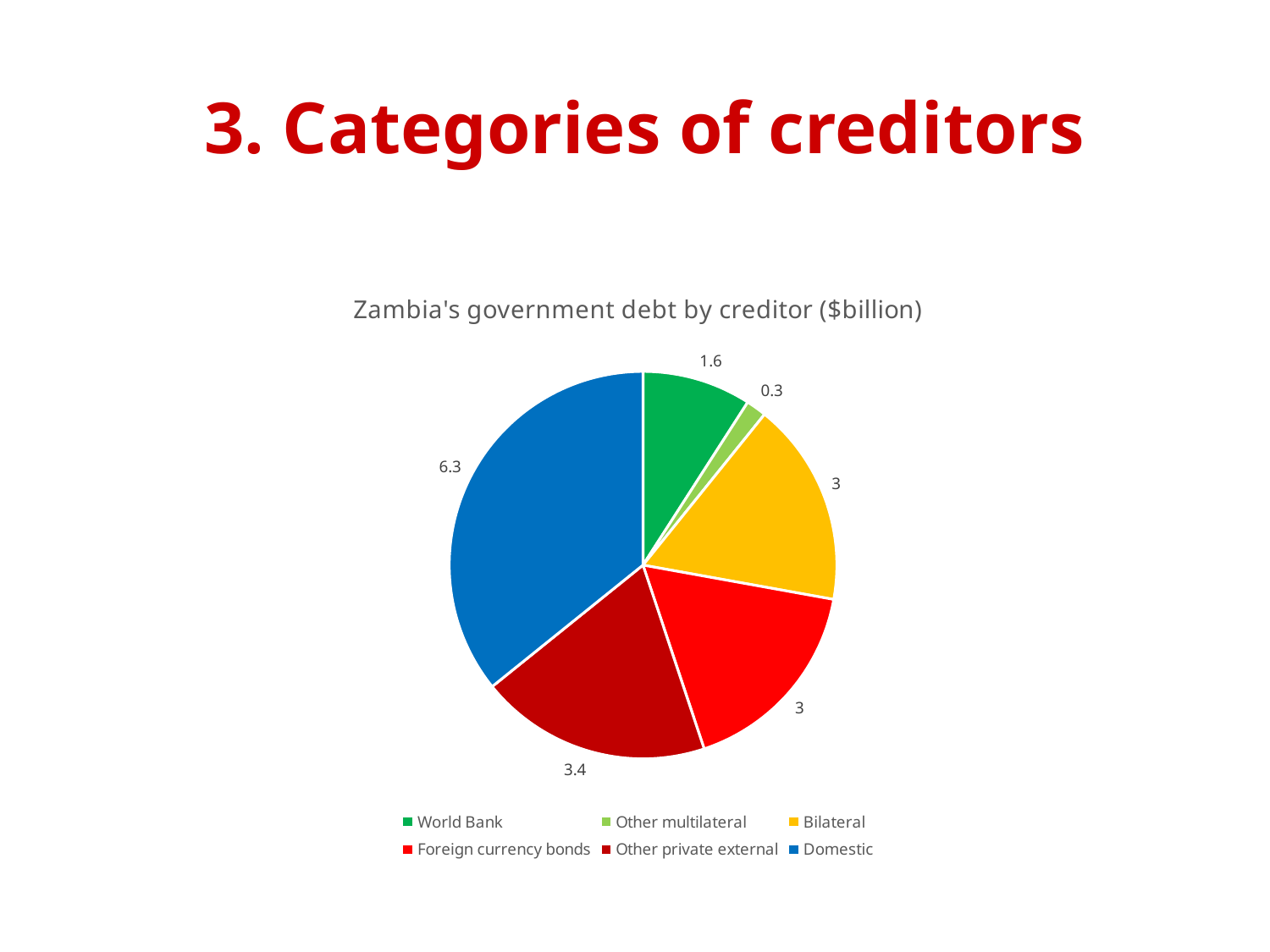
How many entries does the legend list? 6 What is the value for Bilateral in the pie chart? 3 Which creditor category has the smallest slice of the pie chart? Other multilateral Which creditor category has the largest slice of the pie chart? Domestic Which is larger, the value for World Bank or the value for Other multilateral? World Bank What is the difference between the Domestic value and the Other private external value? 2.9 What is the value for Domestic in the pie chart? 6.3 What is the value for Other private external in the pie chart? 3.4 What is the title of the chart? Zambia's government debt by creditor ($billion) What kind of chart is shown on the slide? Pie chart What is the value for World Bank in the pie chart? 1.6 How many slices does the pie chart have? 6